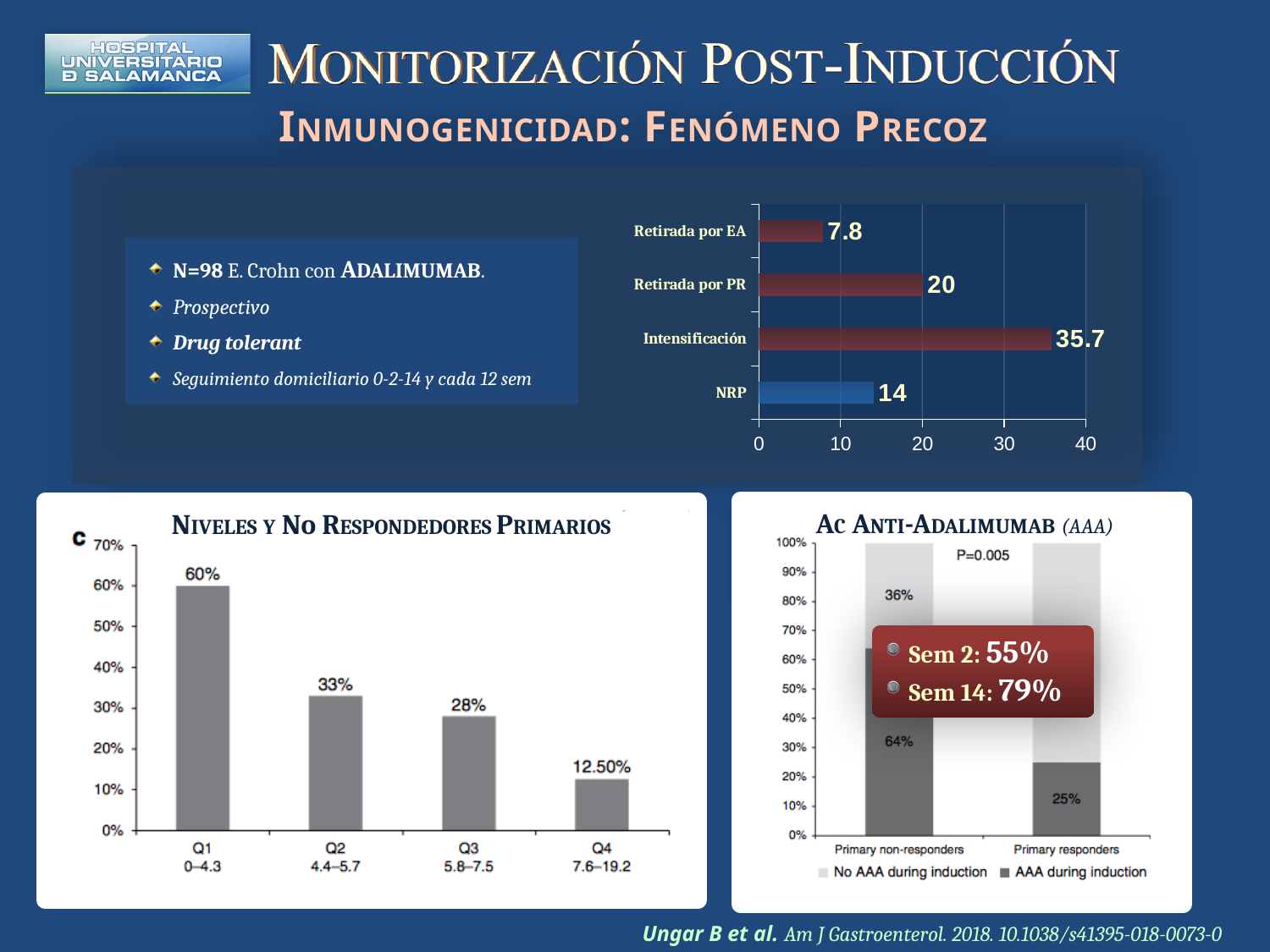
In the top-right bar chart, which category has the lowest value? Retirada por EA In the top-right bar chart, which category has the highest value? Intensificación In the top-right bar chart, how many categories are shown? 4 In the top-right bar chart, what is the value for Intensificación? 35.7 In the top-right bar chart, what is the value for Retirada por EA? 7.8 In the chart titled 'Ac Anti-Adalimumab (AAA)', how many series does the legend list? 2 In the chart titled 'Niveles y No Respondedores Primarios', what is the difference between Q1 and Q3? 32% In the chart titled 'Niveles y No Respondedores Primarios', what is the value for Q4? 12.50% In the chart titled 'Niveles y No Respondedores Primarios', do the values rise or fall from Q1 to Q4? fall In the top-right bar chart, what is the difference between Retirada por PR and NRP? 6 In the chart titled 'Ac Anti-Adalimumab (AAA)', what is the value for AAA during induction among Primary non-responders? 64% In the chart titled 'Niveles y No Respondedores Primarios', what is the value for Q2? 33%